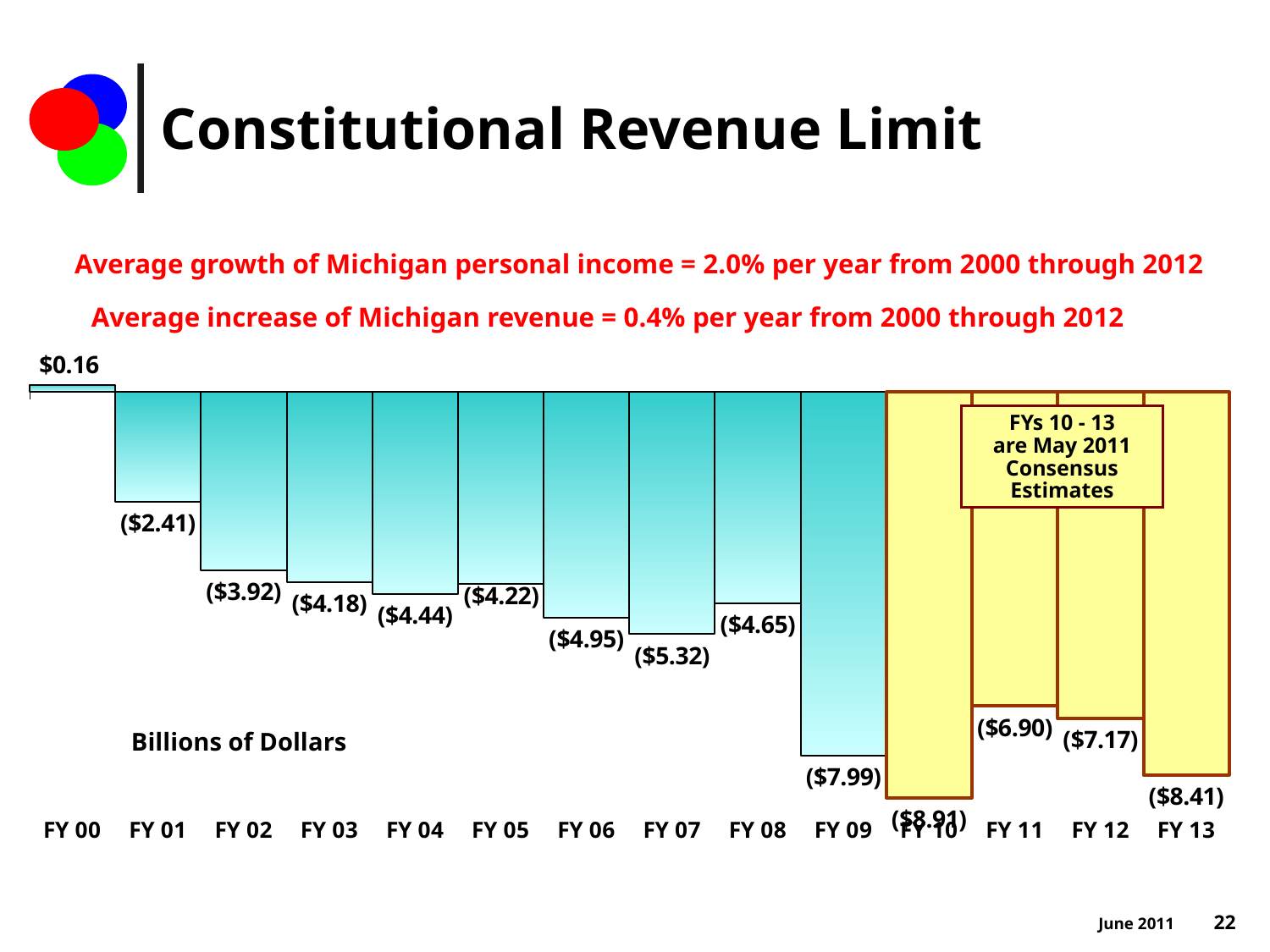
What value is shown for FY 13? ($8.41) Which fiscal year is the only one with a positive value? FY 00 By how much does the FY 09 shortfall exceed the FY 08 shortfall, in billions of dollars? $3.34 According to the note on the chart, which fiscal years are May 2011 Consensus Estimates? FYs 10 - 13 What kind of chart is this? bar chart How many fiscal years are shown on the x axis? 14 What value is shown for FY 00? $0.16 Which fiscal year has the largest negative value (the longest bar below the line)? FY 10 Which has the larger shortfall, FY 06 or FY 07? FY 07 Do the values generally rise or fall from FY 00 through FY 09? fall What value is shown for FY 09? ($7.99) What value is shown for FY 05? ($4.22)